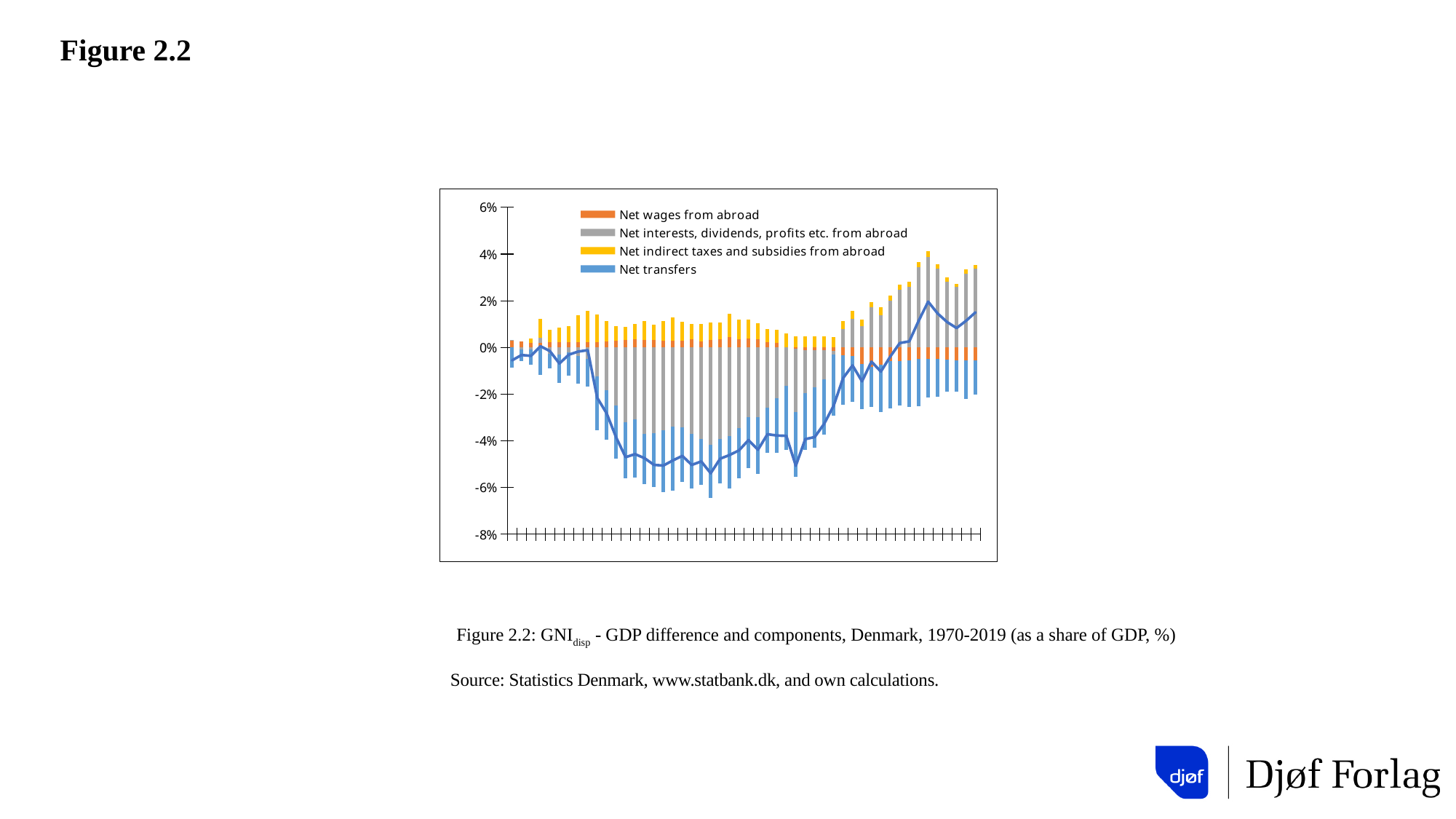
How many series does the legend list? 4 What is the lowest value shown on the vertical axis? -8% Is the lowest point of the line greater or less than -4%? less Which series is plotted below zero in every bar of the chart? Net transfers What kind of chart is shown on the slide? Stacked bar chart with a line Which series makes up the largest positive part of the bars on the right-hand side of the chart? Net interests, dividends, profits etc. from abroad Which series is shown in blue in the legend? Net transfers Which series is shown in orange in the legend? Net wages from abroad Is the highest point of the line greater or less than 1%? greater What is the highest value shown on the vertical axis? 6% Does the line end higher or lower than it starts at the left of the chart? higher Which years does the chart cover, according to the figure caption? 1970-2019